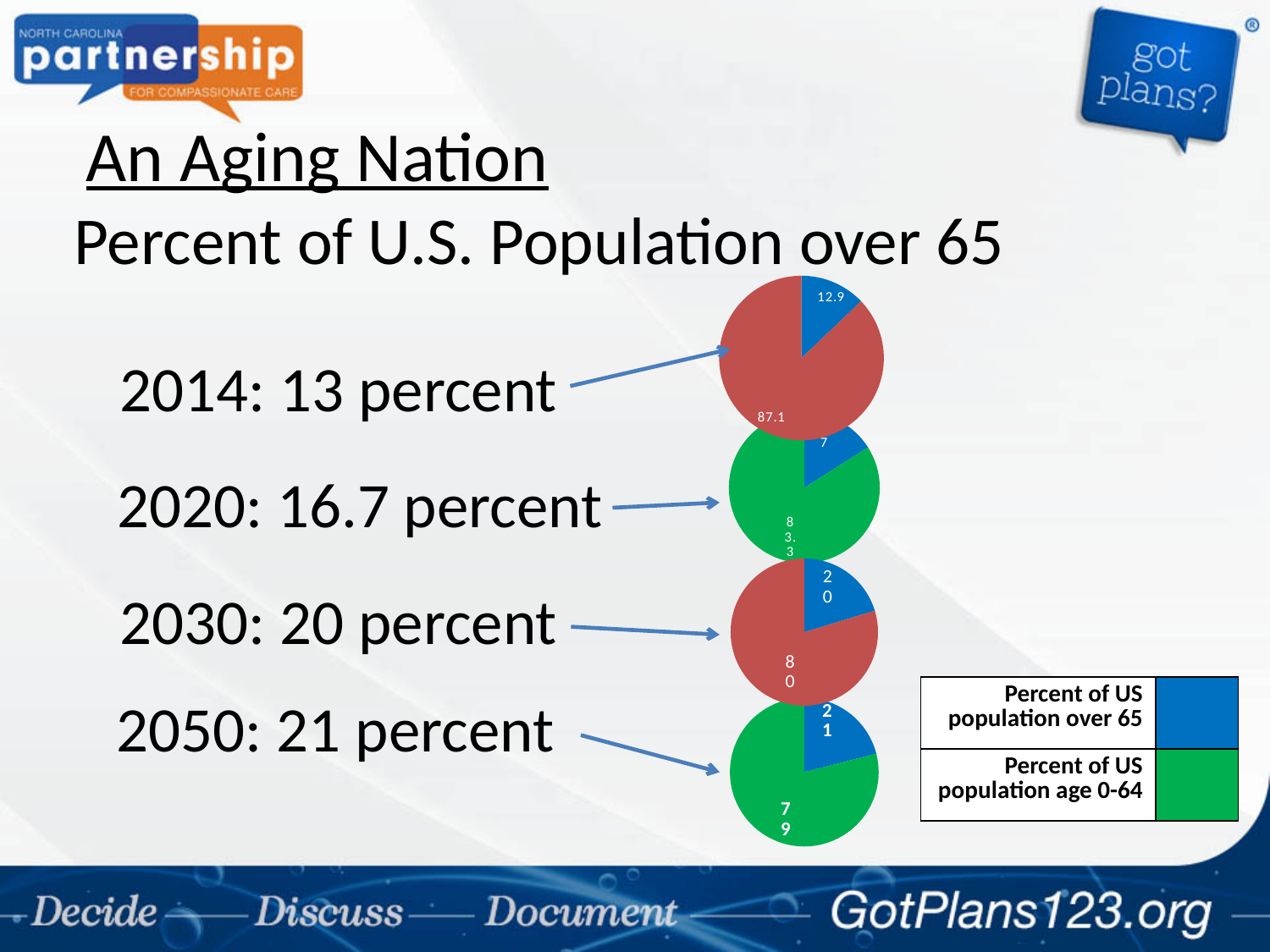
In the top pie chart (2014), what value is shown for the blue slice (percent of US population over 65)? 12.9 In the third pie chart from the top (2030), what value is shown for the red slice? 80 What kind of charts are shown on the slide? Pie charts In the bottom pie chart (2050), what value is shown for the blue slice (percent of US population over 65)? 21 In the bottom pie chart (2050), which slice is larger, the blue slice or the green slice? Green slice According to the legend, which colour represents the percent of US population over 65? Blue In the top pie chart (2014), what value is shown for the red slice? 87.1 How many entries does the legend list? 2 How many pie charts are on the slide? 4 In the bottom pie chart (2050), what value is shown for the green slice (percent of US population age 0-64)? 79 What is the difference between the red slice (87.1) and the blue slice (12.9) in the top pie chart (2014)? 74.2 In the third pie chart from the top (2030), what value is shown for the blue slice (percent of US population over 65)? 20